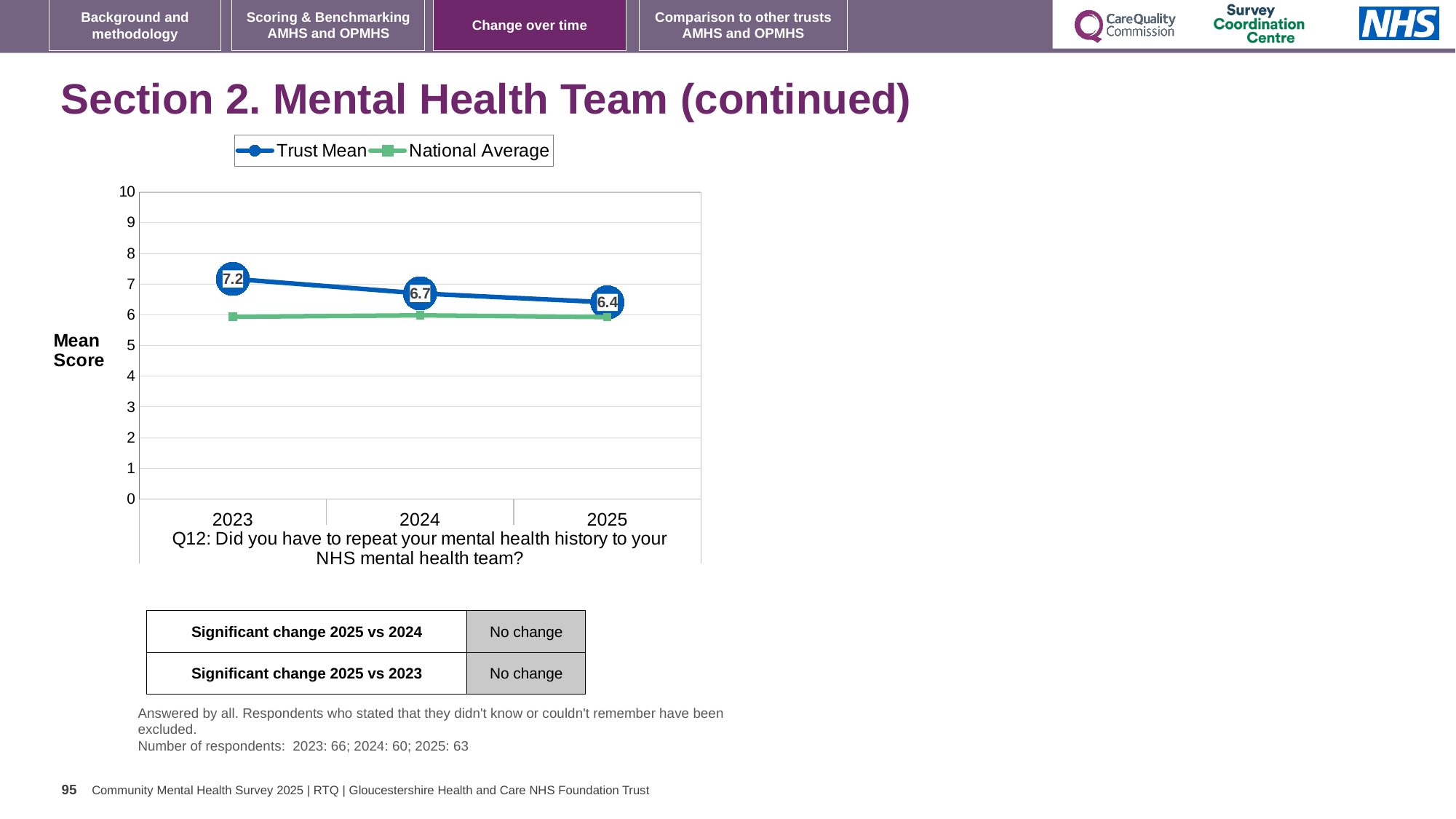
What is the Trust Mean value for 2024? 6.7 What is the difference between the Trust Mean in 2023 and in 2025? 0.8 Does the Trust Mean rise or fall from 2023 to 2025? fall In which year is the Trust Mean lowest? 2025 How many series does the legend list? 2 Is the National Average value for 2023 greater or less than 7? less How many years are shown on the x axis? 3 What is the Trust Mean value for 2025? 6.4 In which year is the Trust Mean highest? 2023 Which is larger in 2024, the Trust Mean or the National Average? Trust Mean What kind of chart is shown? line chart What is the Trust Mean value for 2023? 7.2